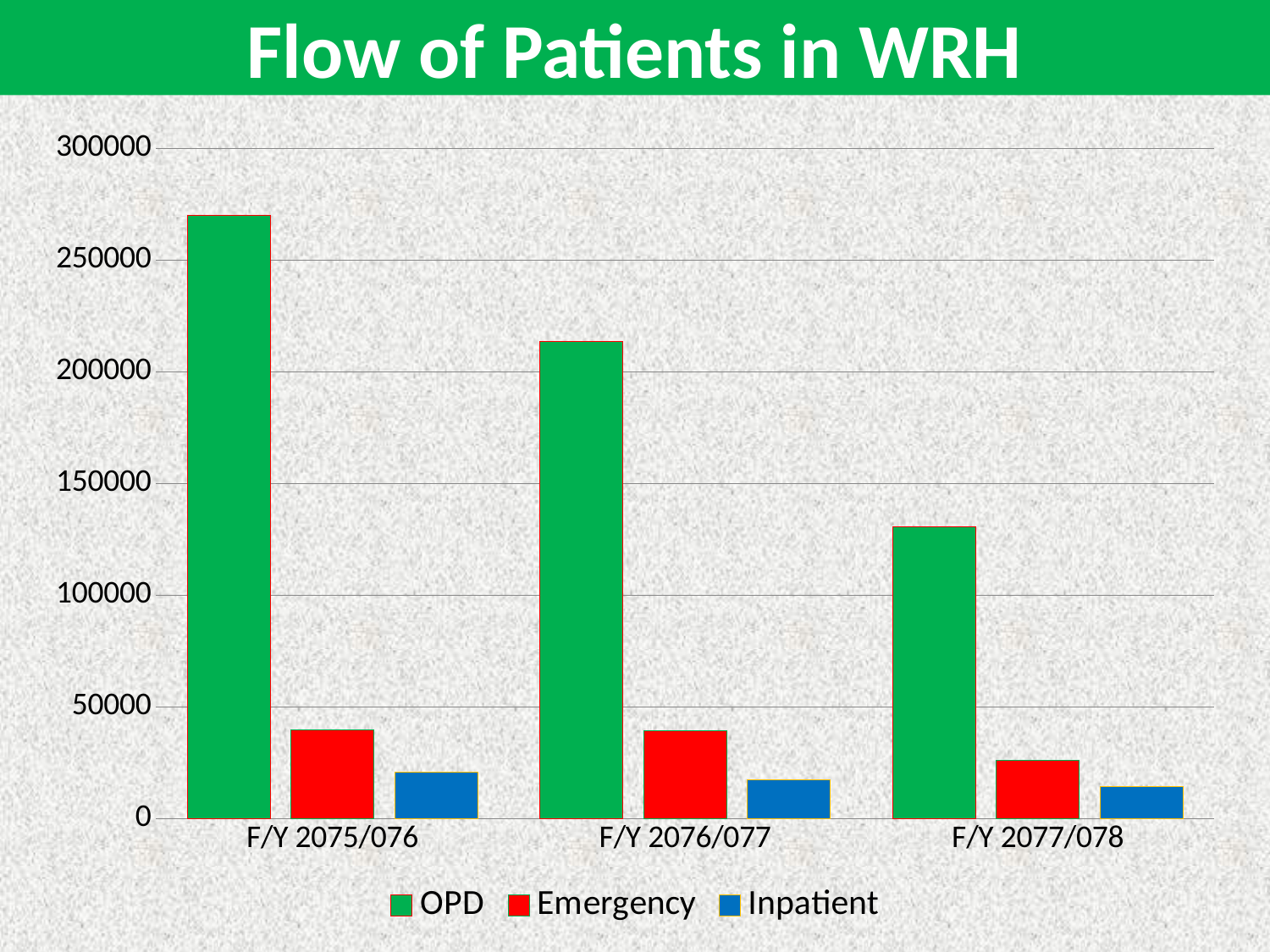
How many series does the legend list? 3 Which fiscal year has the highest OPD value? F/Y 2075/076 How many fiscal year categories are shown on the x axis? 3 Which is larger in F/Y 2076/077, the Emergency value or the Inpatient value? Emergency What is the title of the chart? Flow of Patients in WRH Do the OPD values rise or fall from F/Y 2075/076 to F/Y 2077/078? fall Is the OPD value for F/Y 2075/076 greater or less than 250000? greater Which fiscal year has the lowest OPD value? F/Y 2077/078 Is the OPD value for F/Y 2076/077 greater or less than 200000? greater What kind of chart is shown on the slide? bar chart Is the OPD value for F/Y 2077/078 greater or less than 150000? less